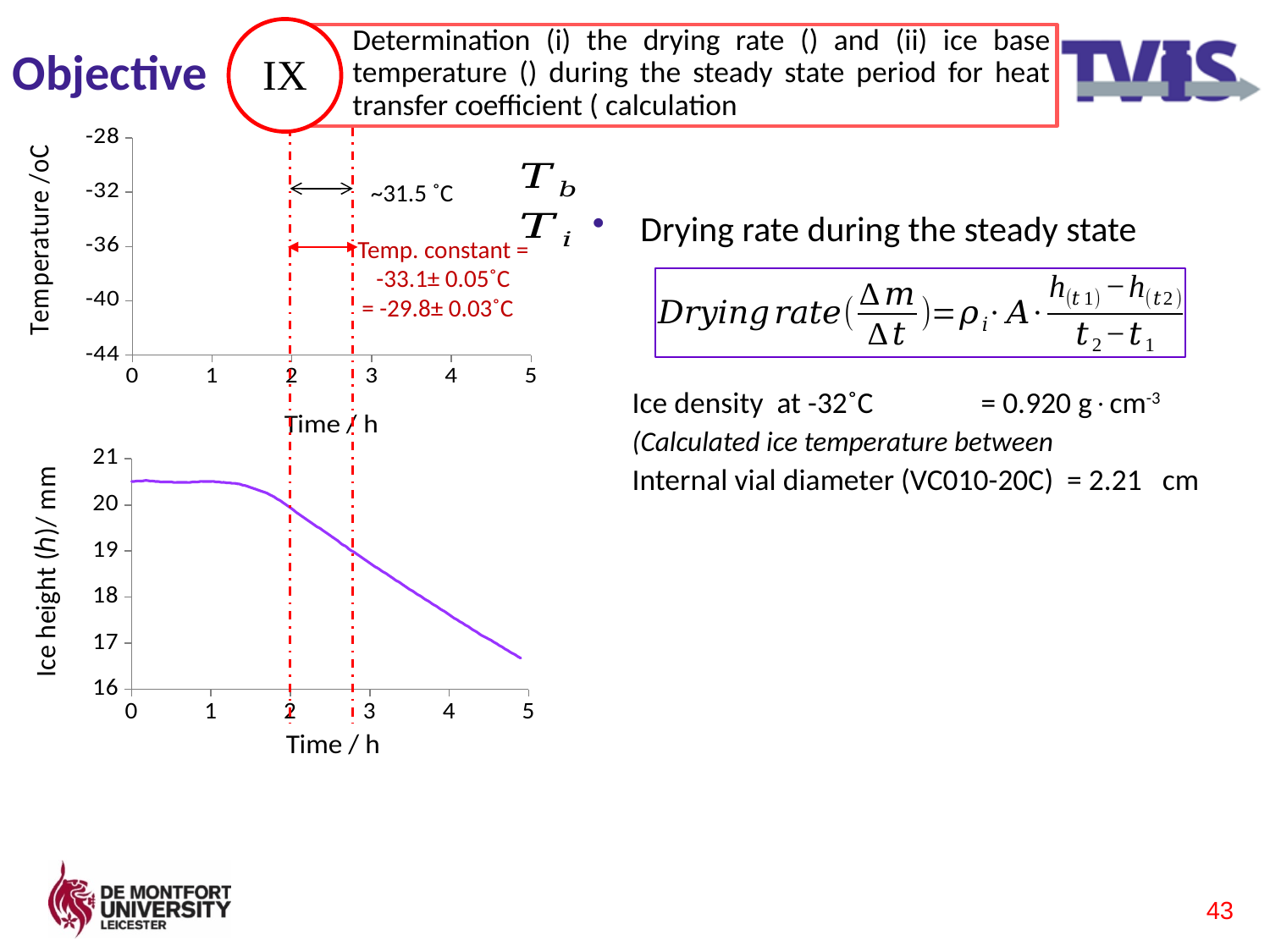
In the bottom chart (Ice height vs Time), what is the maximum value shown on the x-axis? 5 In the top chart (Temperature vs Time), what is the highest value shown on the y-axis? -28 In the bottom chart (Ice height vs Time), is the ice height at time 1 h greater or less than 20 mm? greater In the top chart (Temperature vs Time), what is the lowest value shown on the y-axis? -44 What is the y-axis label of the bottom chart? Ice height (h)/ mm In the bottom chart (Ice height vs Time), is the ice height at time 4 h greater or less than 18 mm? less What is the x-axis label of the top chart? Time / h In the bottom chart (Ice height vs Time), do the values rise or fall as time increases? fall In the bottom chart, which is larger: the ice height at 1 h or the ice height at 4 h? 1 h In the bottom chart (Ice height vs Time), is the ice height at time 0 h greater or less than 20 mm? greater What kind of chart is the bottom chart (Ice height vs Time)? line chart